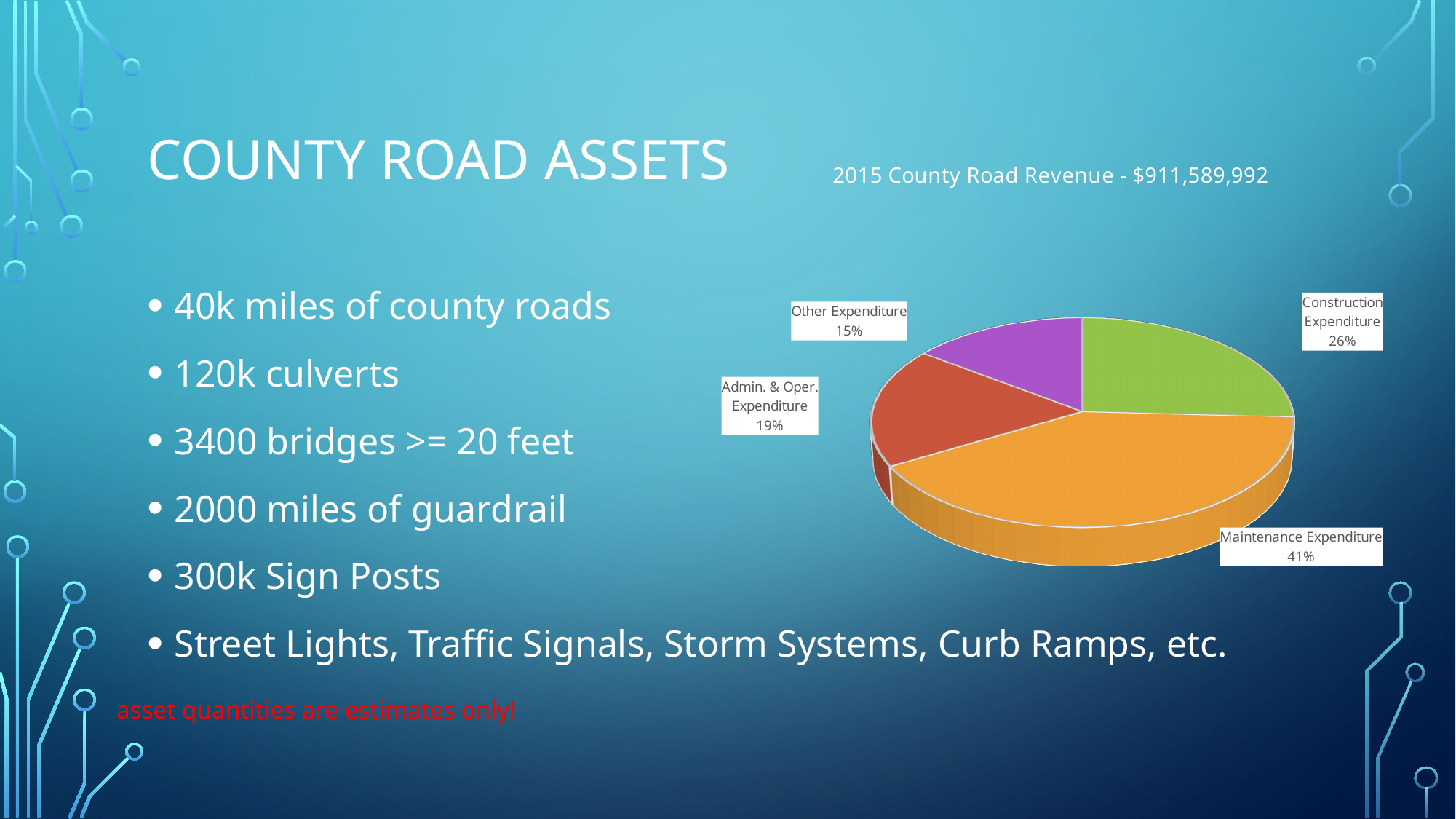
What is the 2015 County Road Revenue stated above the chart? $911,589,992 What share of the pie does Construction Expenditure represent? 26% What share of the pie does Maintenance Expenditure represent? 41% What colour is the Maintenance Expenditure slice? Orange How many slices does the pie chart have? 4 Which expenditure category has the smallest slice of the pie? Other Expenditure What kind of chart is shown on the slide? Pie chart What share of the pie does Admin. & Oper. Expenditure represent? 19% Which expenditure category has the largest slice of the pie? Maintenance Expenditure What is the difference in percentage points between Maintenance Expenditure and Construction Expenditure? 15 What share of the pie does Other Expenditure represent? 15% Which is larger, Admin. & Oper. Expenditure or Other Expenditure? Admin. & Oper. Expenditure